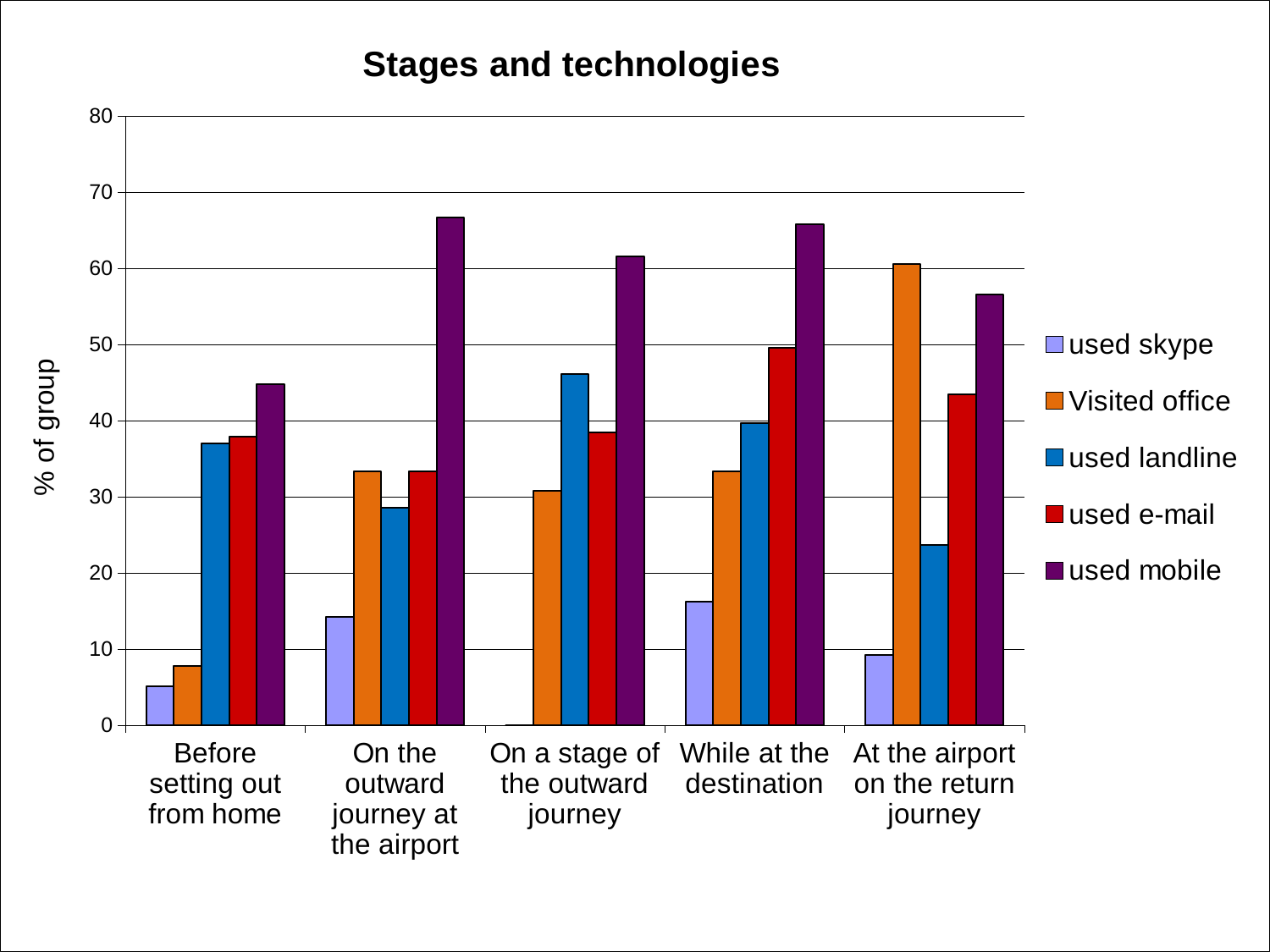
Which series has the highest value for "While at the destination"? used mobile For "At the airport on the return journey", which is larger: "Visited office" or "used landline"? Visited office How many stages (categories) are shown along the x axis? 5 Is the value for "used landline" on a stage of the outward journey greater or less than 40? greater How many series does the legend list? 5 What kind of chart is shown on the slide? bar chart Which series has the lowest value for "At the airport on the return journey"? used skype Is the value for "used landline" at the airport on the return journey greater or less than 30? less Is the value for "used mobile" at the airport on the return journey greater or less than 50? greater What is the label on the y axis? % of group Which stage has the highest value for "Visited office"? At the airport on the return journey Which stage has the lowest value for "used skype"? On a stage of the outward journey